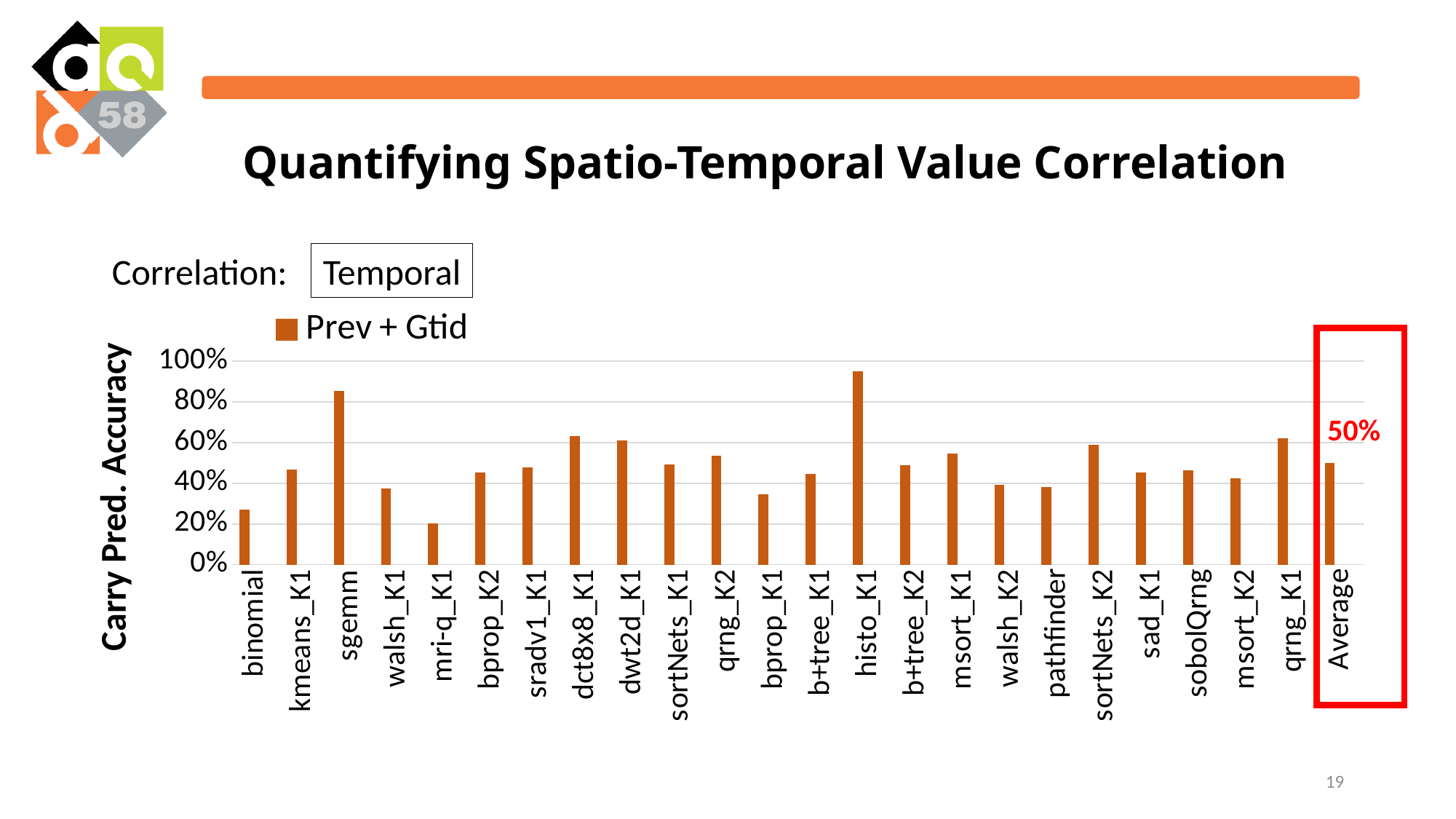
Is the value for sgemm greater or less than 80%? greater How many categories are shown on the x axis? 24 What is the label of the y axis? Carry Pred. Accuracy What type of chart is shown on the slide? bar chart Is the value for dct8x8_K1 greater or less than 60%? greater Is the value for binomial greater or less than 40%? less Which category has the highest Carry Pred. Accuracy? histo_K1 What is the name of the series in the legend? Prev + Gtid Which is larger, the value for sgemm or the value for walsh_K1? sgemm What is the value for Average? 50% How many series does the legend list? 1 Which category has the lowest Carry Pred. Accuracy? mri-q_K1